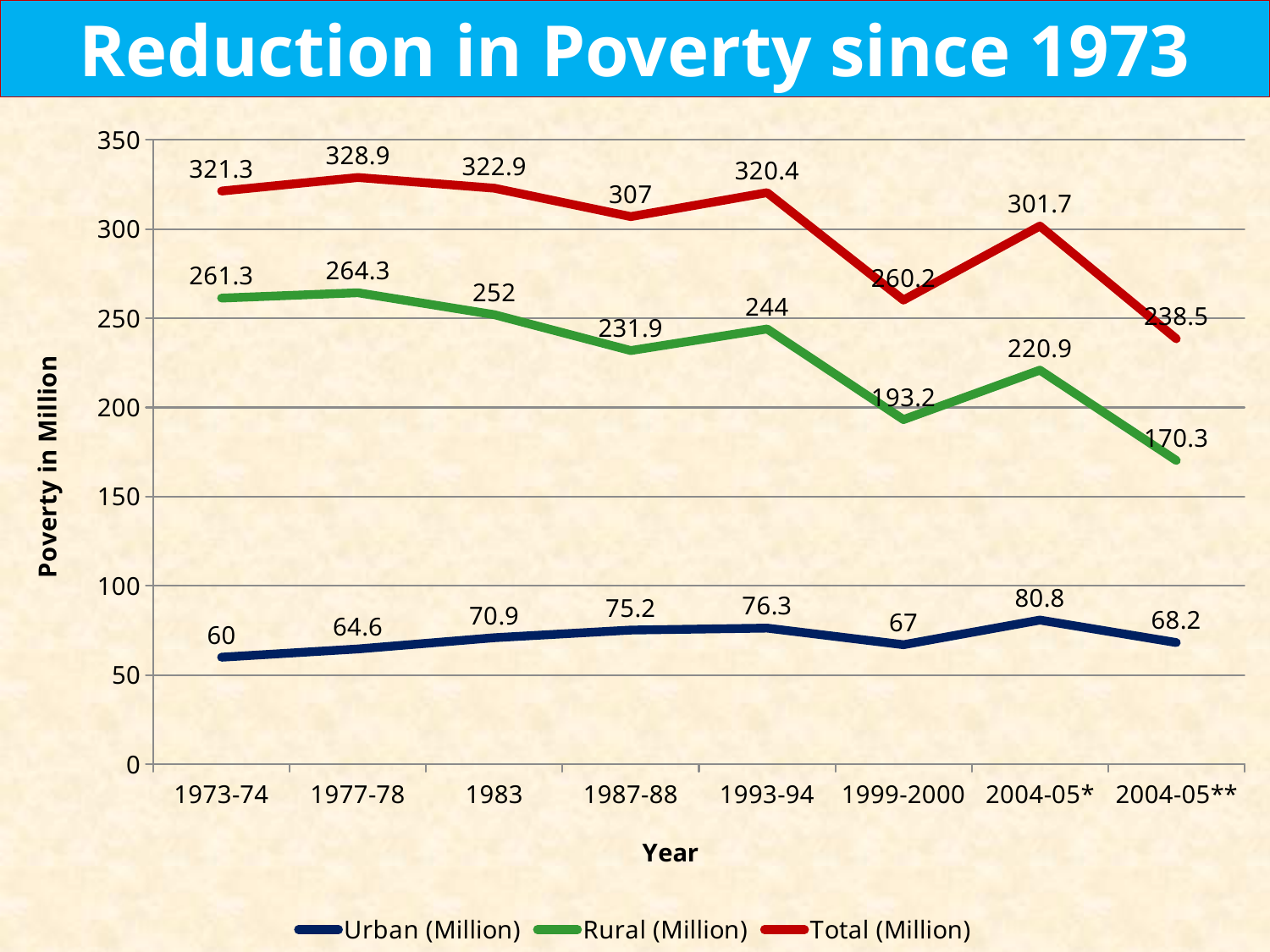
Does the Rural (Million) series generally rise or fall from 1973-74 to 2004-05**? fall What is the difference between the Total (Million) values for 1973-74 and 2004-05**? 82.8 What is the Rural (Million) value for 1999-2000? 193.2 What kind of chart is shown on the slide? line chart How many years are shown on the x axis? 8 In which year is the Total (Million) series highest? 1977-78 What is the title of the chart? Reduction in Poverty since 1973 What is the Total (Million) value for 1977-78? 328.9 In which year is the Rural (Million) series lowest? 2004-05** Which is larger, the Urban (Million) value for 1993-94 or for 1999-2000? 1993-94 What is the Urban (Million) value for 2004-05*? 80.8 How many series does the legend list? 3